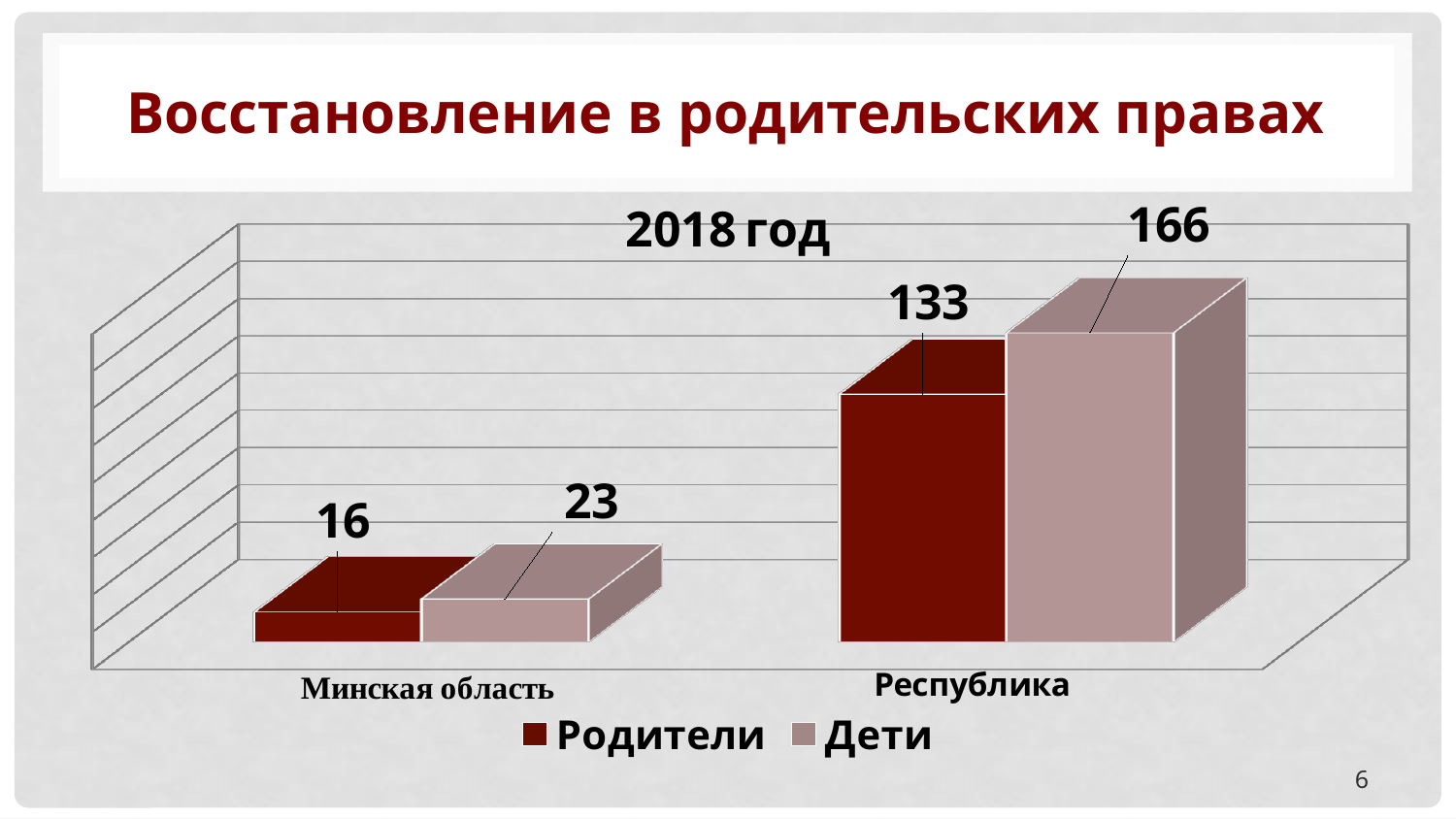
How many series does the legend list? 2 What is the difference between Дети and Родители in Минская область? 7 Which is larger in Республика: Родители or Дети? Дети What is the value for Родители in Республика? 133 How many categories are shown on the x axis? 2 Which category has the highest value for Дети? Республика What is the value for Дети in Минская область? 23 Which category has the lowest value for Родители? Минская область What is the value for Родители in Минская область? 16 What is the difference between Дети and Родители in Республика? 33 What is the value for Дети in Республика? 166 What kind of chart is shown? Bar chart